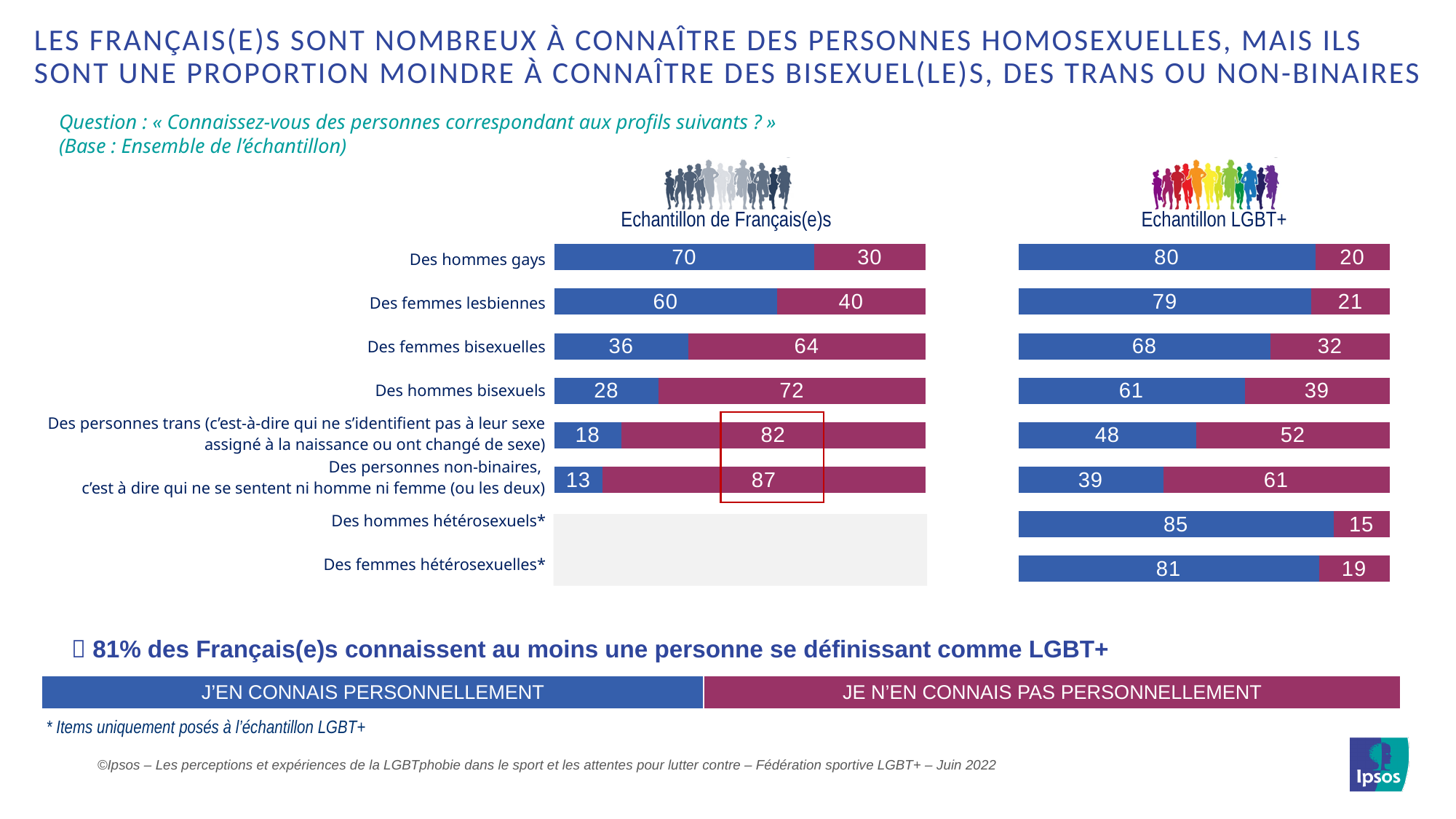
In the 'Echantillon LGBT+' chart, what is the value for 'Je n'en connais pas personnellement' for 'Des hommes bisexuels'? 39 How many categories have bars plotted in the 'Echantillon de Français(e)s' chart? 6 Which colour represents 'Je n'en connais pas personnellement' in the charts? Red (magenta) How many series does the legend at the bottom of the slide list? 2 What is the difference between the 'J'en connais personnellement' value for 'Des hommes gays' in the 'Echantillon LGBT+' chart and in the 'Echantillon de Français(e)s' chart? 10 How many categories have bars plotted in the 'Echantillon LGBT+' chart? 8 In the 'Echantillon de Français(e)s' chart, which is larger: the 'J'en connais personnellement' value for 'Des femmes bisexuelles' or for 'Des hommes bisexuels'? Des femmes bisexuelles In the 'Echantillon de Français(e)s' chart, what percentage say they personally know gay men ('Des hommes gays')? 70 What type of chart is used for the 'Echantillon LGBT+' data? Stacked bar chart In the 'Echantillon LGBT+' chart, which category has the highest 'J'en connais personnellement' value? Des hommes hétérosexuels In the 'Echantillon de Français(e)s' chart, what is the total of the stacked bar for 'Des personnes trans'? 100 In the 'Echantillon de Français(e)s' chart, which category has the lowest 'J'en connais personnellement' value? Des personnes non-binaires